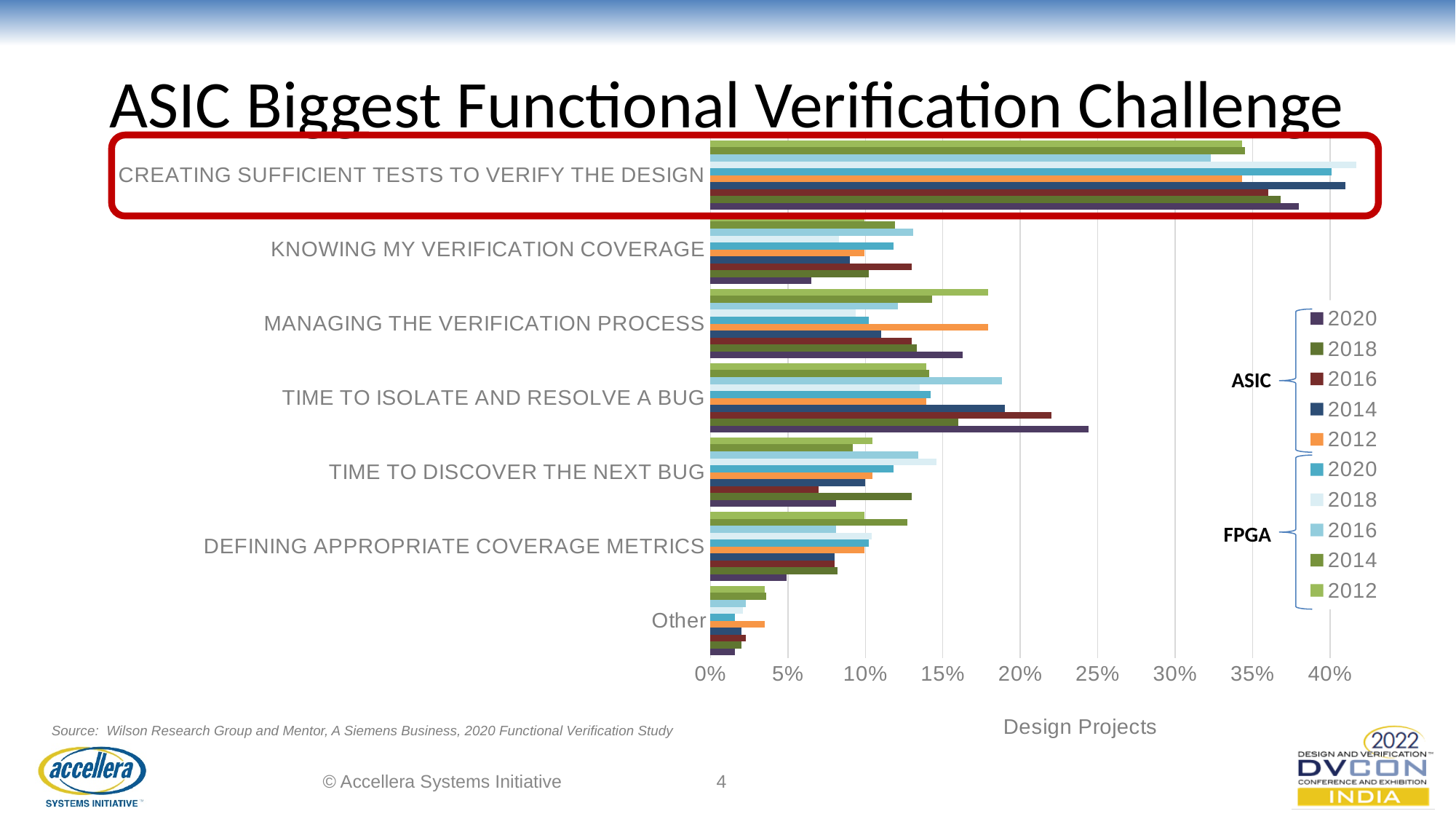
Is the ASIC 2020 value for 'Creating sufficient tests to verify the design' greater or less than 35%? greater Is the FPGA 2018 value for 'Creating sufficient tests to verify the design' greater or less than 35%? greater For 'Time to isolate and resolve a bug', which is larger: the ASIC 2020 value or the ASIC 2018 value? ASIC 2020 What kind of chart is shown on the slide? Bar chart How many challenge categories are listed on the vertical axis of the chart? 7 Which category has the highest values across the series in the chart? Creating sufficient tests to verify the design What is the label on the horizontal axis of the chart? Design Projects Which category has the lowest values across the series in the chart? Other How many series does the chart's legend list in total? 10 Is the ASIC 2020 value for 'Knowing my verification coverage' greater or less than 10%? less What are the two groups into which the legend divides the series? ASIC and FPGA